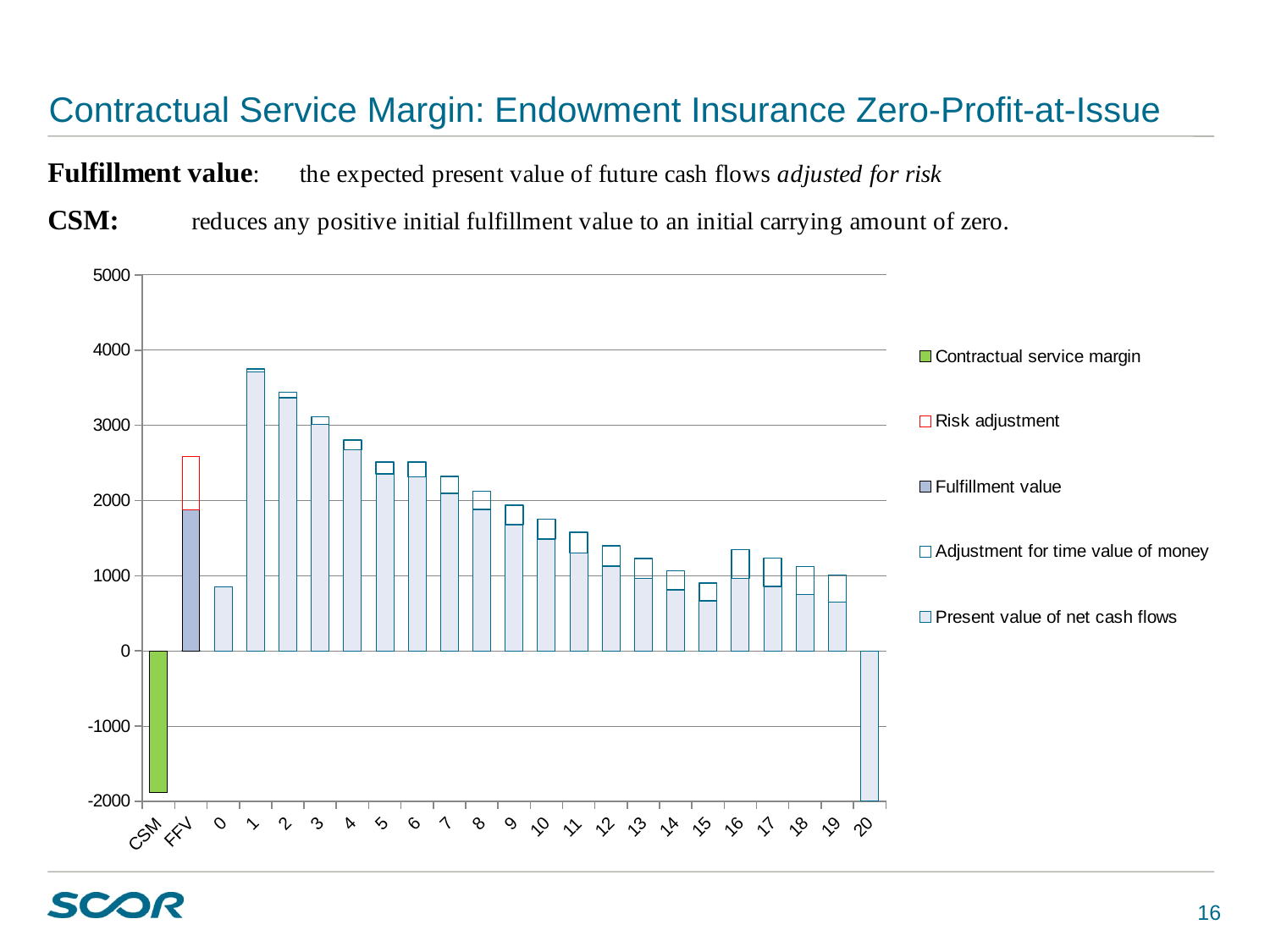
How many series does the legend list? 5 Is the total value of the FFV bar greater or less than 2000? greater Is the value for category 0 greater or less than 1000? less What kind of chart is shown on the slide? Stacked bar chart Among the categories 0 to 20, which has the highest total bar? 1 Do the total bar values generally rise or fall from category 1 to category 19? fall How many categories are shown along the x axis? 23 Is the value for category 20 greater or less than -1000? less Which series is shown in green? Contractual service margin Which has the larger total bar, category 5 or category 10? 5